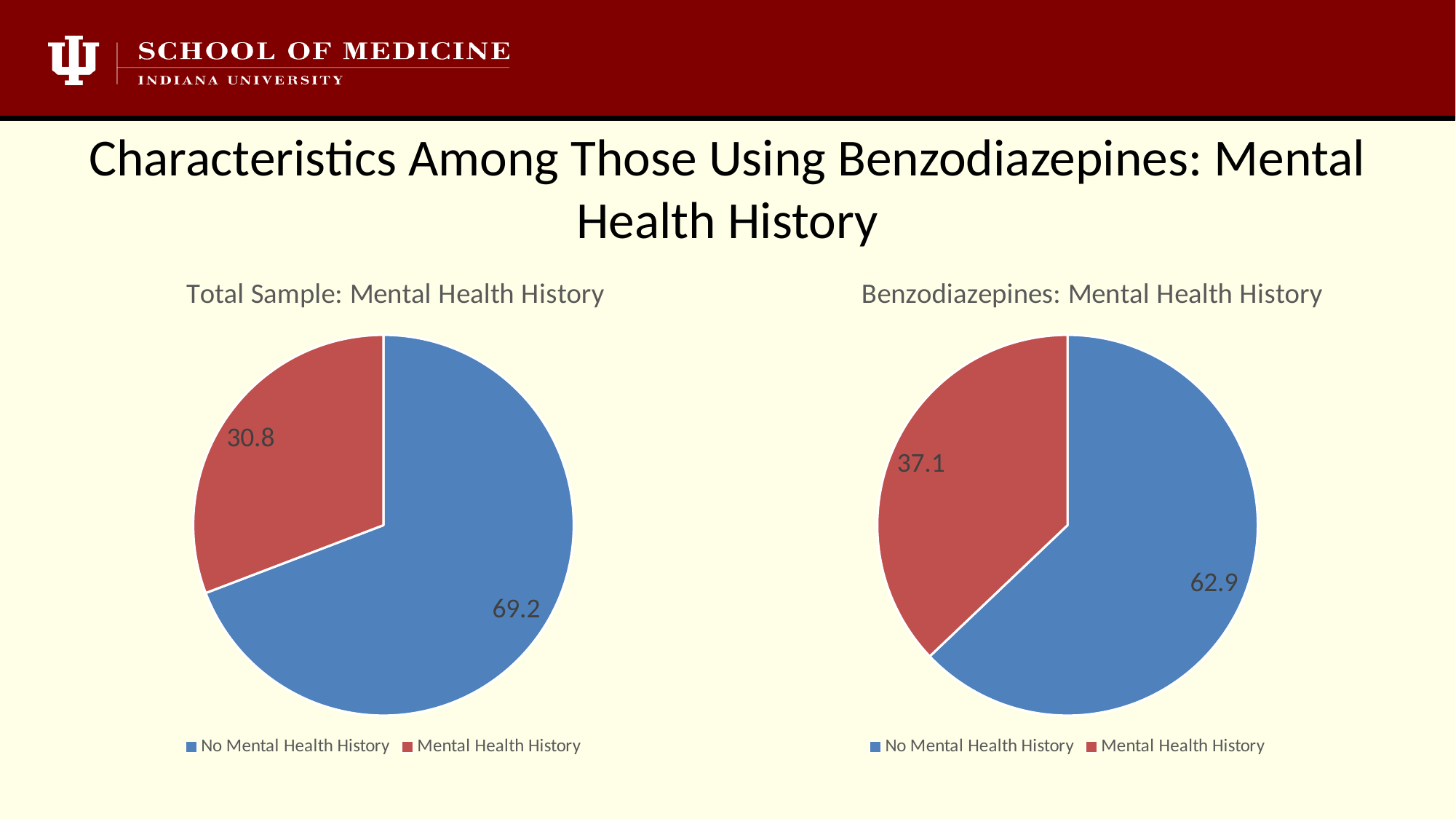
In the 'Benzodiazepines: Mental Health History' chart, what is the value for No Mental Health History? 62.9 In the 'Total Sample: Mental Health History' chart, what is the value for No Mental Health History? 69.2 In the 'Total Sample: Mental Health History' chart, what is the difference between the No Mental Health History and Mental Health History values? 38.4 How many categories does the 'Benzodiazepines: Mental Health History' chart show? 2 In the 'Benzodiazepines: Mental Health History' chart, what is the difference between the No Mental Health History and Mental Health History values? 25.8 In the 'Benzodiazepines: Mental Health History' chart, what is the value for Mental Health History? 37.1 In the 'Total Sample: Mental Health History' chart, what colour is the Mental Health History slice? Red What kind of chart is the 'Total Sample: Mental Health History' chart? Pie chart In the 'Total Sample: Mental Health History' chart, what is the value for Mental Health History? 30.8 In the 'Total Sample: Mental Health History' chart, which category has the smallest slice? Mental Health History In the 'Benzodiazepines: Mental Health History' chart, which category has the largest slice? No Mental Health History Is the Mental Health History value larger in the 'Total Sample: Mental Health History' chart or the 'Benzodiazepines: Mental Health History' chart? Benzodiazepines: Mental Health History